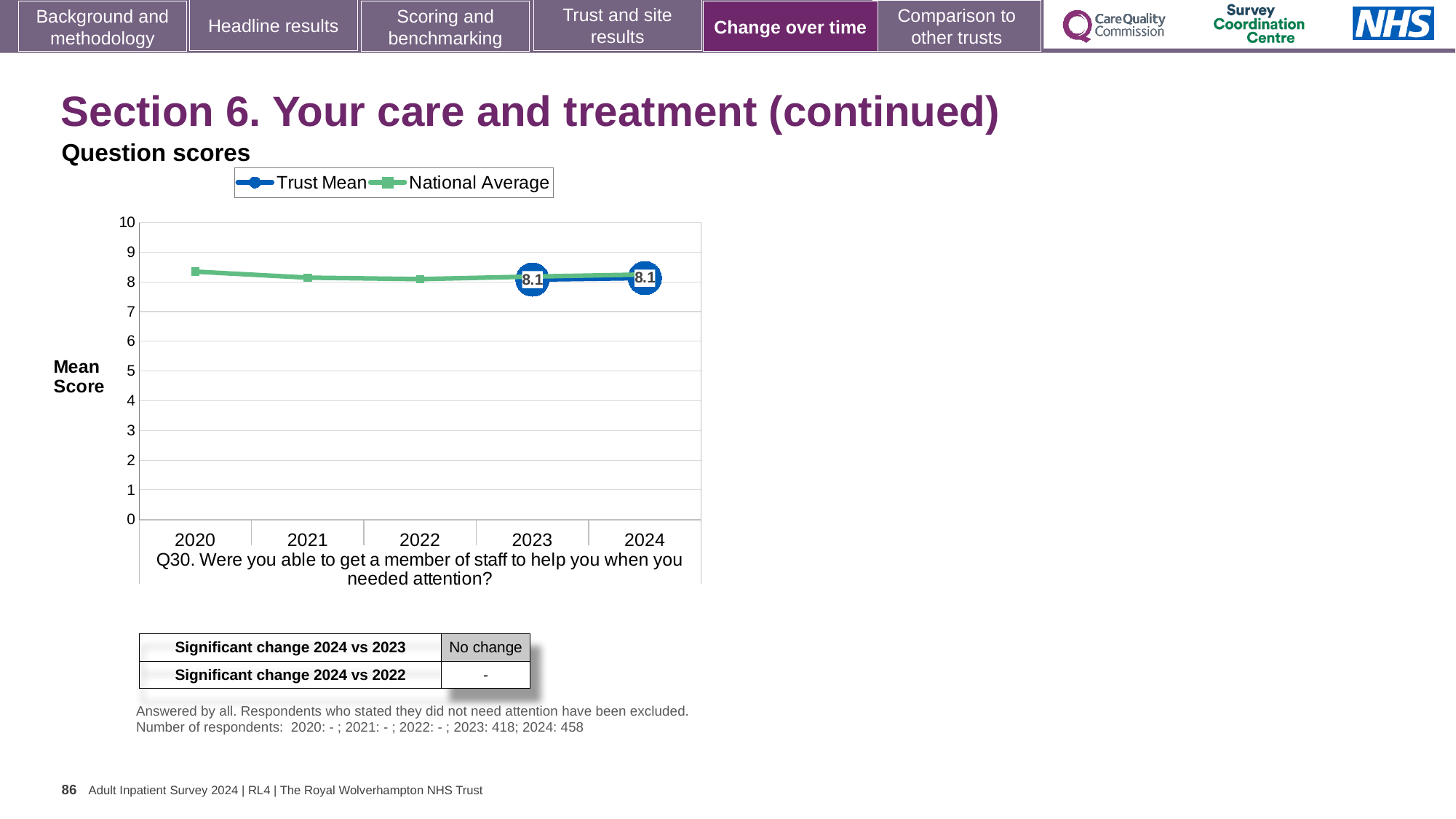
How many years are shown on the x axis of the chart? 5 What is the Trust Mean score for 2023? 8.1 Is the National Average value for 2022 greater or less than 9? less How many series does the chart legend list? 2 Which two series are listed in the chart legend? Trust Mean and National Average What is the Trust Mean score for 2024? 8.1 Does the Trust Mean rise, fall or stay the same from 2023 to 2024? stays the same What is the label on the y axis of the chart? Mean Score What is the first year shown on the x axis of the chart? 2020 What kind of chart is shown on the slide? line chart Is the National Average value for 2020 greater or less than 8? greater What is the difference between the Trust Mean score in 2024 and in 2023? 0